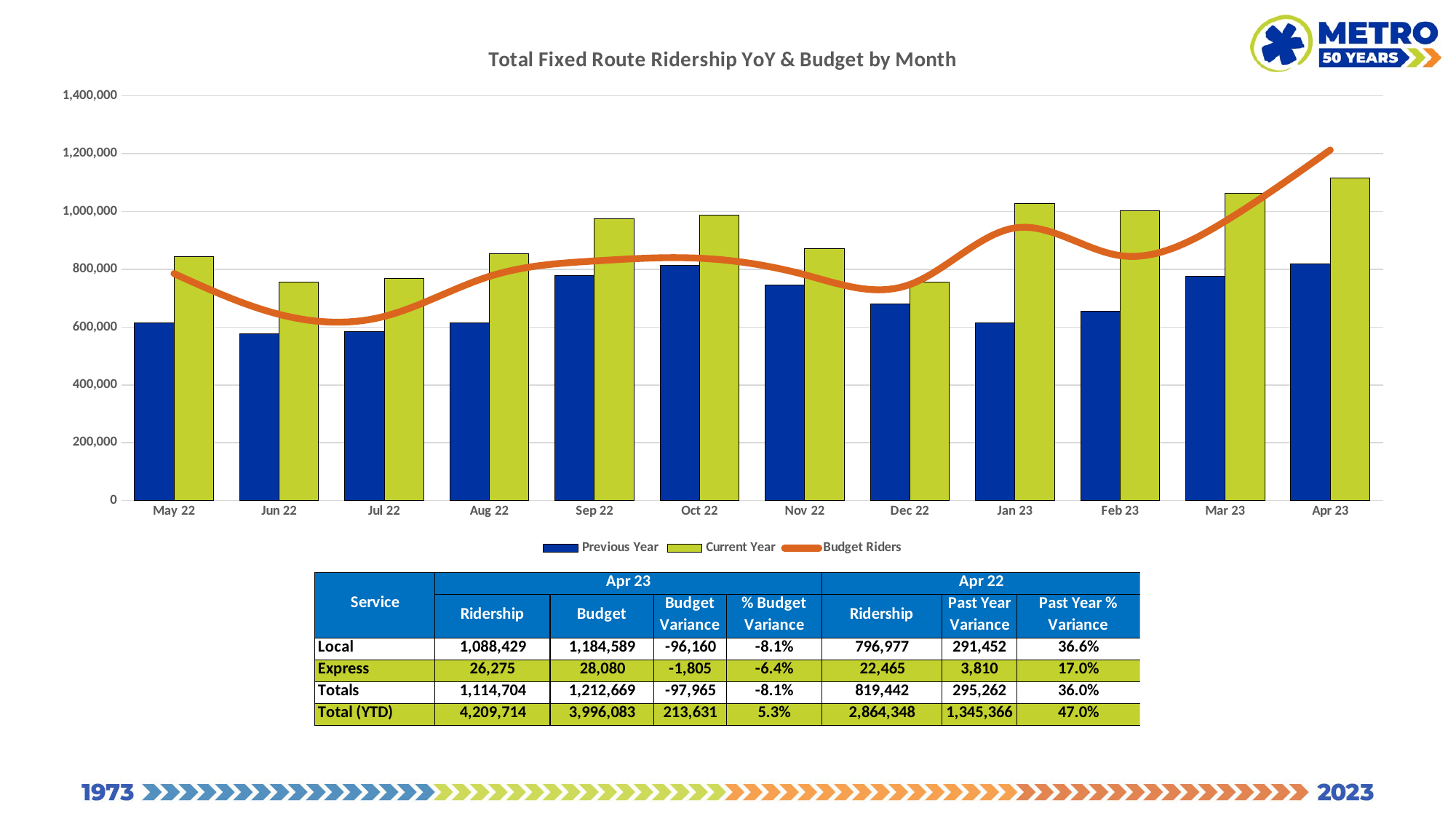
Is the Budget Riders value for Jun 22 greater or less than 800,000? less What is the title of the chart? Total Fixed Route Ridership YoY & Budget by Month How many series does the chart legend list? 3 Which series is drawn as an orange line in the chart? Budget Riders Does the Current Year series rise or fall from Dec 22 to Apr 23? Rise Is the Previous Year value for May 22 greater or less than 600,000? greater How many months are shown on the x axis of the chart? 12 Is the Current Year value for Jun 22 greater or less than 800,000? less What kind of chart is used to show the Previous Year and Current Year series? Bar chart In Apr 23, which is larger: the Current Year bar or the Previous Year bar? Current Year In which month is the Current Year bar the highest? Apr 23